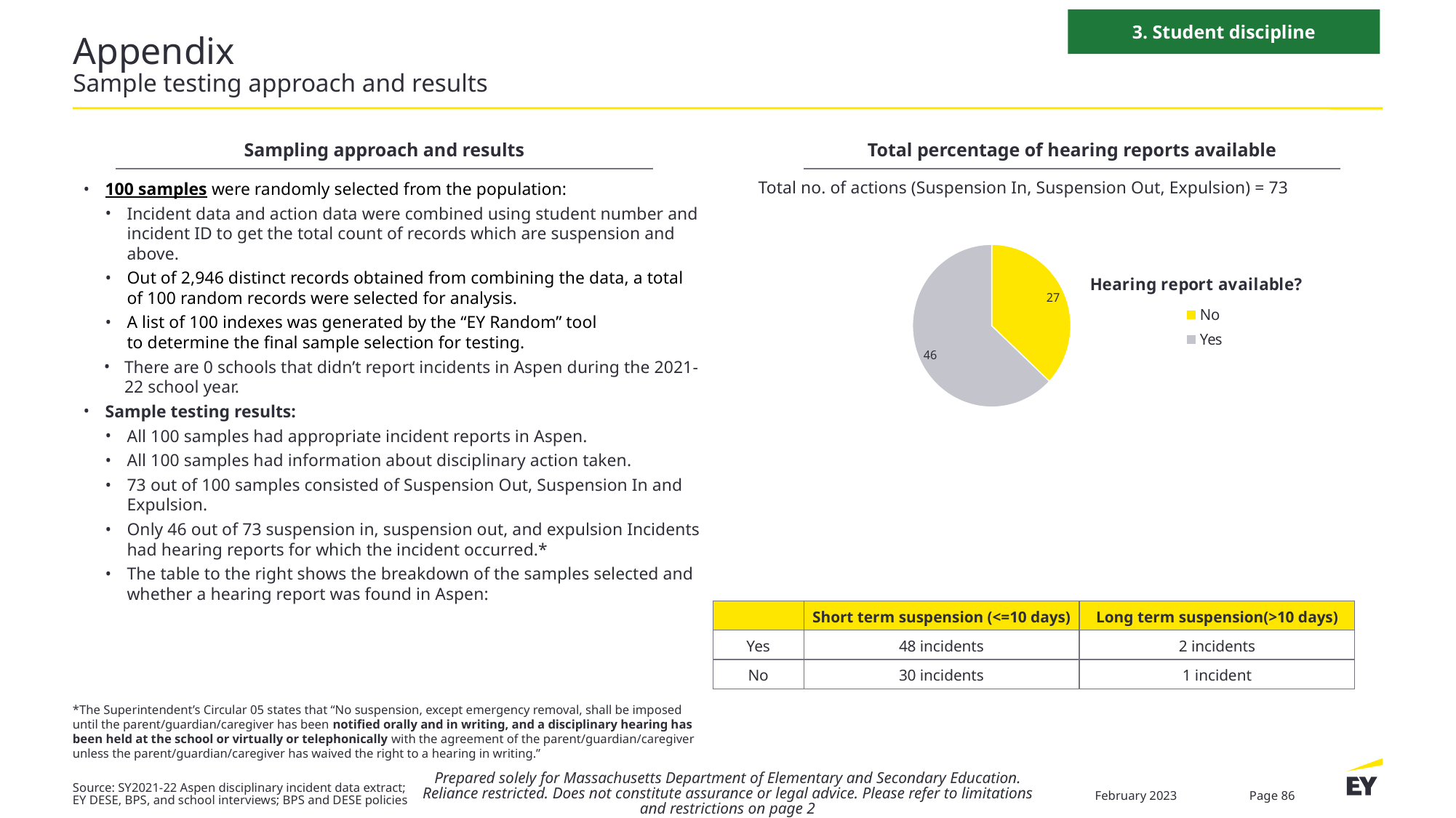
Which slice of the pie chart is the largest? Yes How many entries does the pie chart legend list? 2 In the pie chart, what is the value for the "Yes" slice? 46 What is the total of the two slices in the pie chart? 73 Which slice of the pie chart is the smallest? No What colour is the "No" slice in the pie chart? Yellow What kind of chart is shown on the slide? Pie chart How many slices does the pie chart have? 2 What share of the pie chart does the "Yes" slice represent, to the nearest whole percent? 63% In the pie chart, what is the value for the "No" slice? 27 What is the difference between the "Yes" and "No" values in the pie chart? 19 Which is larger in the pie chart, "Yes" or "No"? Yes